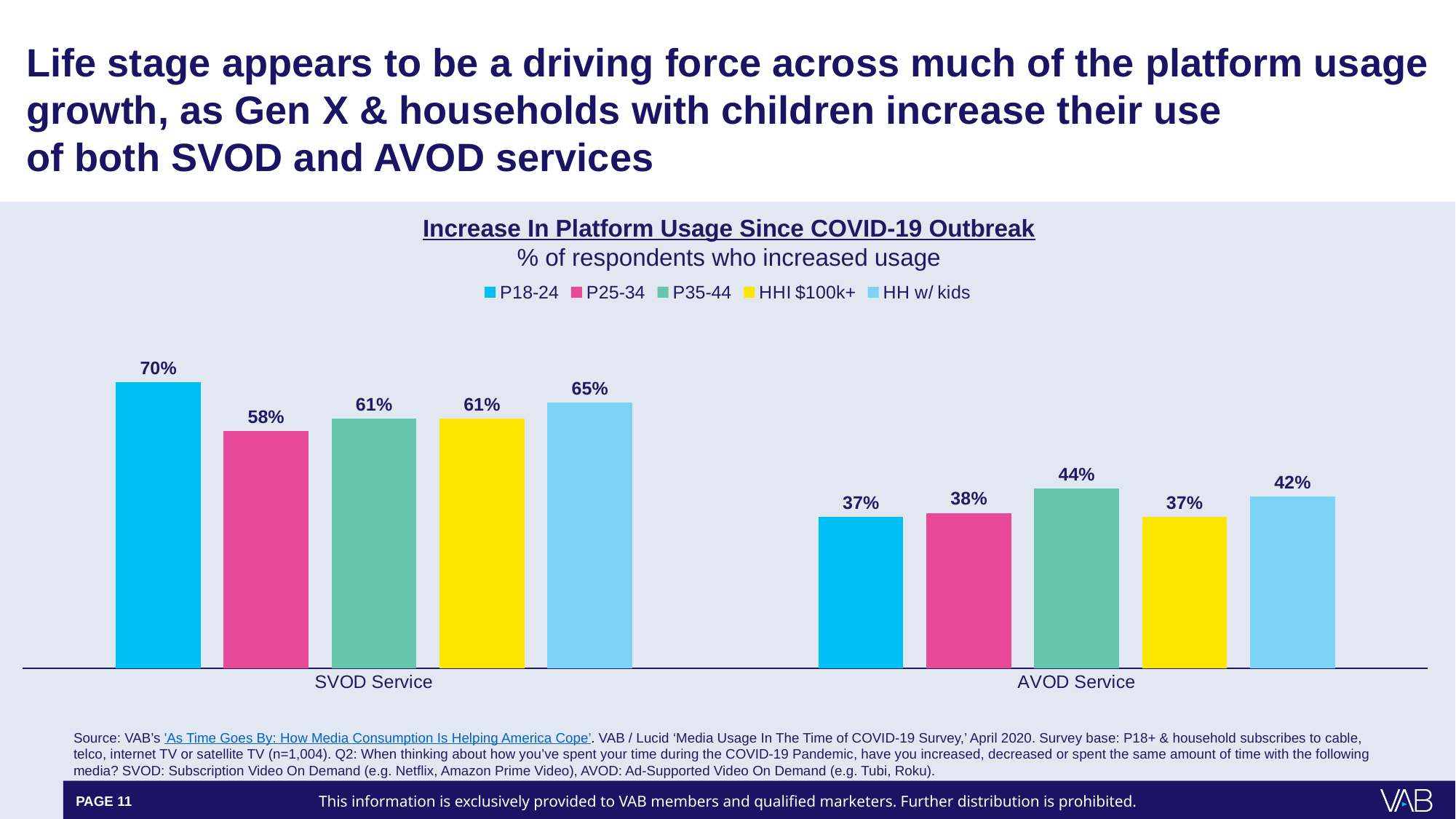
What is the value for HHI $100k+ for AVOD Service? 37% How many categories are shown on the x axis? 2 Which series has the highest value for SVOD Service? P18-24 Which is larger: the HH w/ kids value for SVOD Service or the P25-34 value for SVOD Service? HH w/ kids for SVOD Service What is the value for HH w/ kids for SVOD Service? 65% Which series has the highest value for AVOD Service? P35-44 What is the value for P35-44 for AVOD Service? 44% What is the difference between the P18-24 values for SVOD Service and AVOD Service? 33% Which series has the lowest value for SVOD Service? P25-34 What kind of chart is shown on the slide? Bar chart How many series does the legend list? 5 What percentage of P18-24 respondents increased their SVOD Service usage? 70%